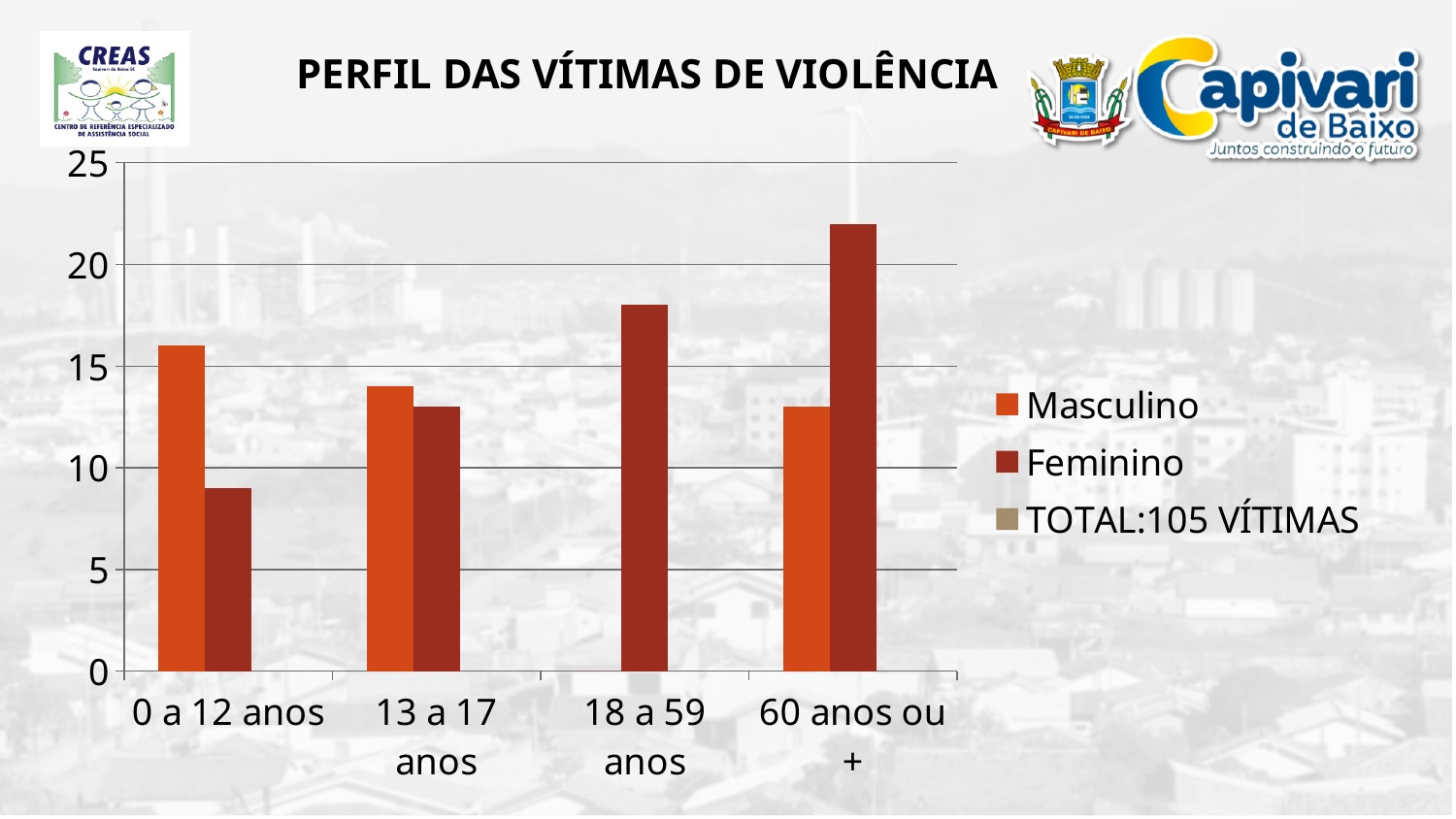
What kind of chart is shown on the slide? Bar chart How many age categories are shown on the x axis? 4 Is the Feminino value for 60 anos ou + greater or less than 20? greater Is the Masculino value for 0 a 12 anos greater or less than 15? greater Which age category has the highest Feminino value? 60 anos ou + Which age category has the lowest Feminino value? 0 a 12 anos What is the title of the chart? PERFIL DAS VÍTIMAS DE VIOLÊNCIA Is the Feminino value for 0 a 12 anos greater or less than 10? less Which age category has the highest Masculino value? 0 a 12 anos For 60 anos ou +, which is larger, Masculino or Feminino? Feminino How many entries does the legend list? 3 For 0 a 12 anos, which is larger, Masculino or Feminino? Masculino